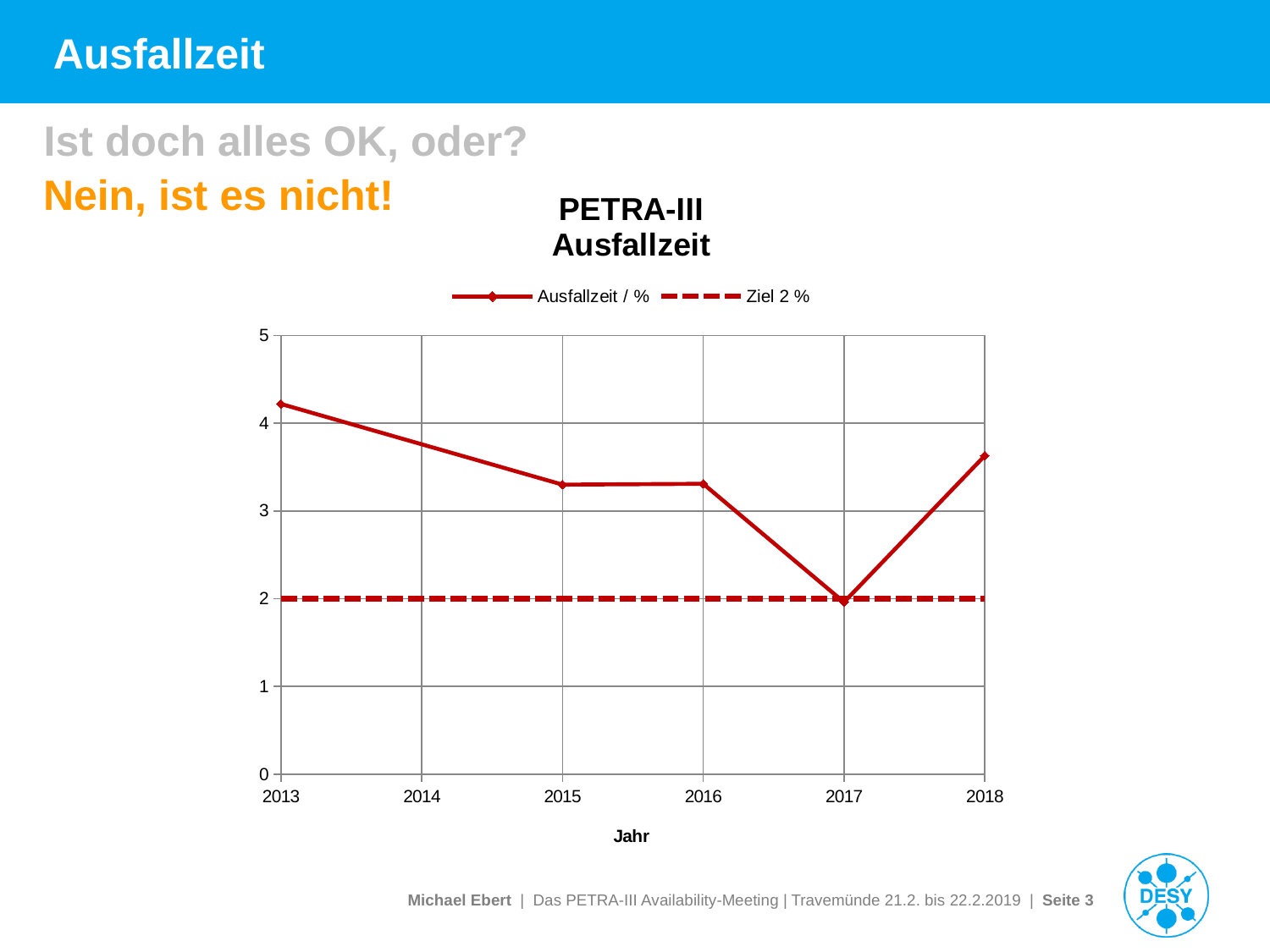
What are the two series named in the chart legend? Ausfallzeit / % and Ziel 2 % What kind of chart is shown on the slide? line chart How many series does the chart legend list? 2 Is the Ausfallzeit / % value for 2013 greater or less than 4? greater In which year is the Ausfallzeit / % value lowest? 2017 Does the Ausfallzeit / % value rise or fall from 2013 to 2017? fall In which year is the Ausfallzeit / % value highest? 2013 Is the Ausfallzeit / % value for 2016 greater or less than 4? less Which year has the larger Ausfallzeit / % value, 2013 or 2018? 2013 How many years are labelled on the x axis of the chart? 6 What is the title of the chart? PETRA-III Ausfallzeit Is the Ausfallzeit / % value for 2018 greater or less than 3? greater